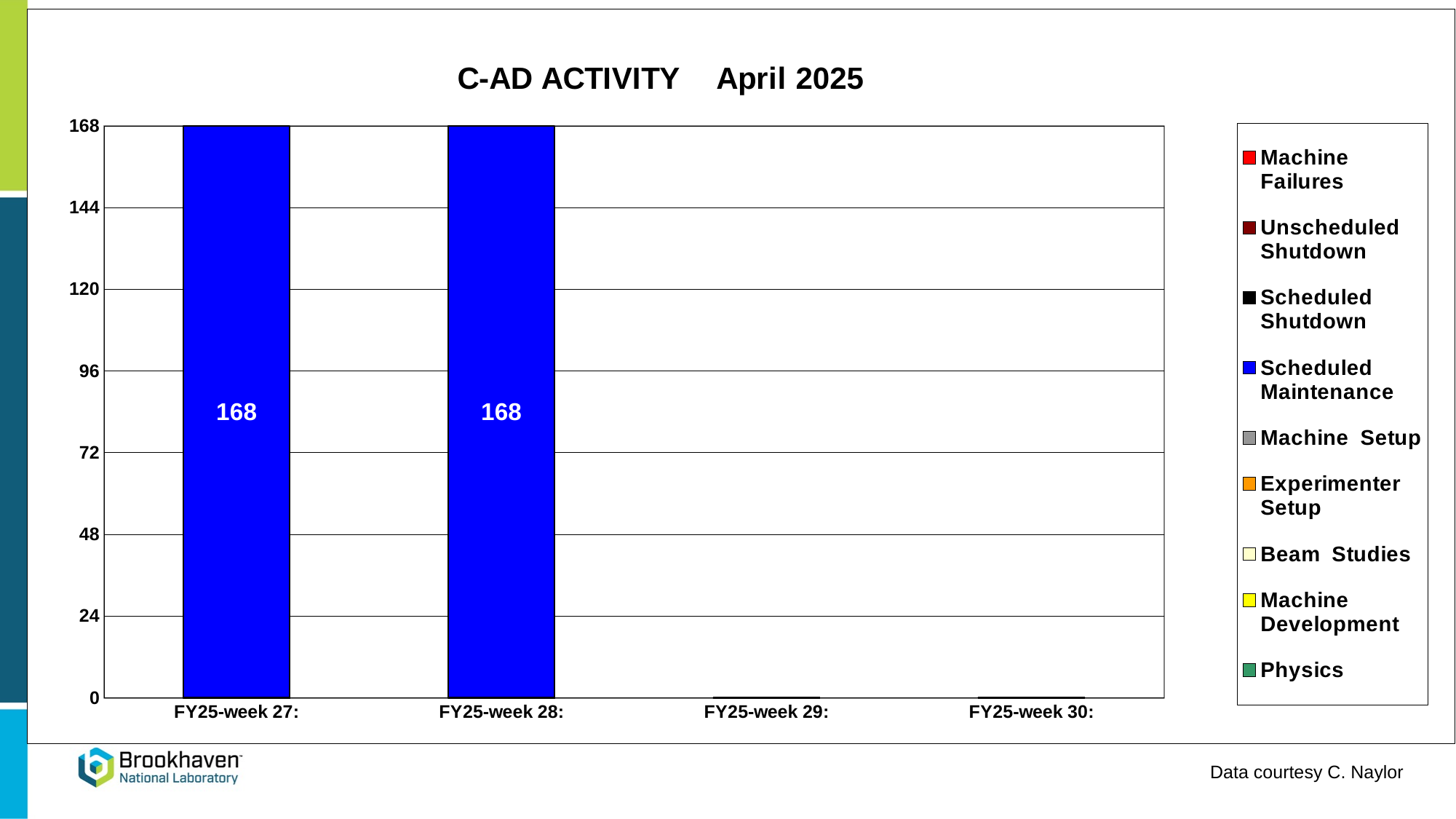
What is the value of the Scheduled Maintenance bar for FY25-week 27? 168 Which series is shown in blue in the legend? Scheduled Maintenance What is the highest value shown on the y axis? 168 What is the difference between the values for FY25-week 27 and FY25-week 28? 0 What kind of chart is shown on the slide? bar chart How many series does the legend list? 9 What is the title of the chart? C-AD ACTIVITY April 2025 How many week categories are shown on the x axis? 4 Which is larger, the value for FY25-week 28 or the value for FY25-week 30? FY25-week 28 Is the value for FY25-week 27 greater or less than 144? greater Is the value for FY25-week 29 greater or less than 24? less What is the value of the Scheduled Maintenance bar for FY25-week 28? 168